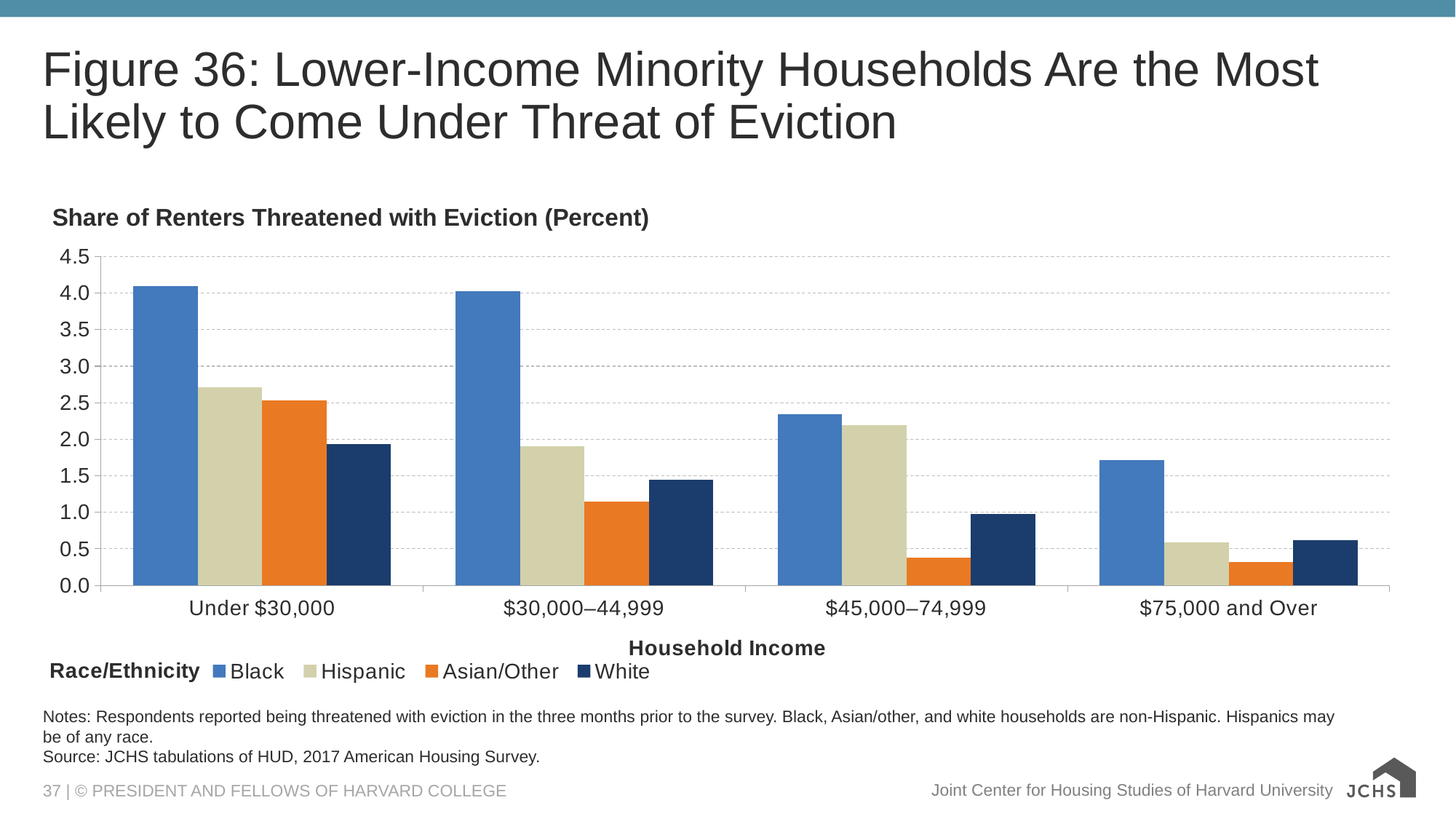
In the Under $30,000 income category, which is larger: the share for Asian/Other renters or the share for White renters? Asian/Other What is the label of the x axis? Household Income Is the share of White renters threatened with eviction in the $30,000–44,999 category greater or less than 1.5? less Which race/ethnicity group has the lowest share of renters threatened with eviction in the $45,000–74,999 income category? Asian/Other Is the share of Asian/Other renters threatened with eviction in the $75,000 and Over category greater or less than 0.5? less How many race/ethnicity series does the legend list? 4 Which race/ethnicity group has the highest share of renters threatened with eviction in the Under $30,000 income category? Black Does the share of Black renters threatened with eviction generally rise or fall as household income increases? fall In the $30,000–44,999 income category, which is larger: the share for Hispanic renters or the share for Asian/Other renters? Hispanic What kind of chart is shown on the slide? bar chart Is the share of Black renters threatened with eviction in the Under $30,000 category greater or less than 4.0? greater How many household income categories are shown on the x axis? 4